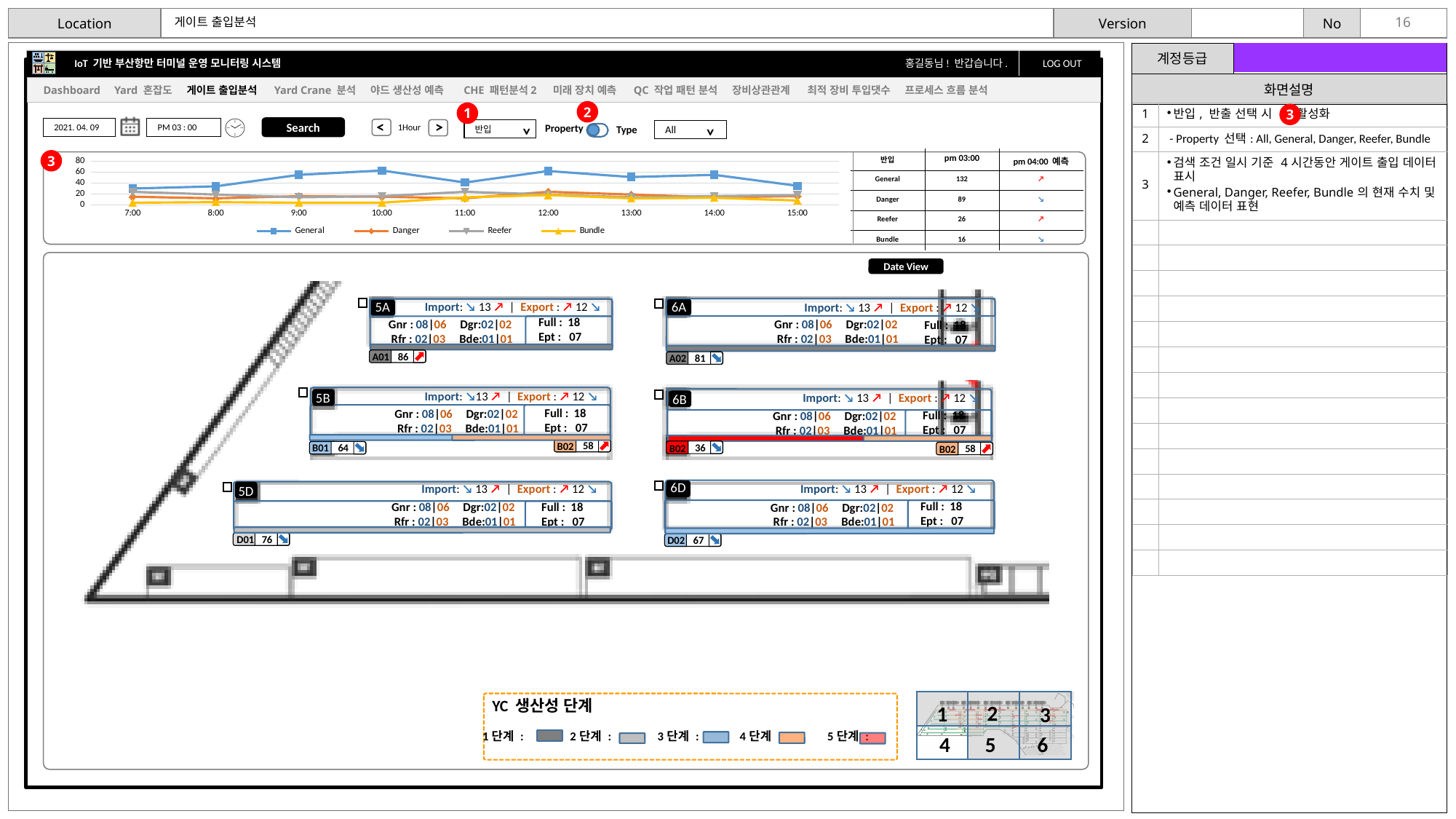
What are the series names in the legend of the line chart? General, Danger, Reefer, Bundle Is the value for General at 7:00 greater or less than 40? less What kind of chart is shown at the top of the slide? line chart What is the first time label on the x axis of the line chart? 7:00 How many series does the legend of the line chart list? 4 At 9:00, which is larger, the value for General or the value for Danger? General Is the value for General at 10:00 greater or less than 40? greater How many time points are shown on the x axis of the line chart? 9 Is the value for Bundle at 7:00 greater or less than 20? less Which series has the highest values across the line chart? General At 12:00, which is larger, the value for General or the value for Bundle? General